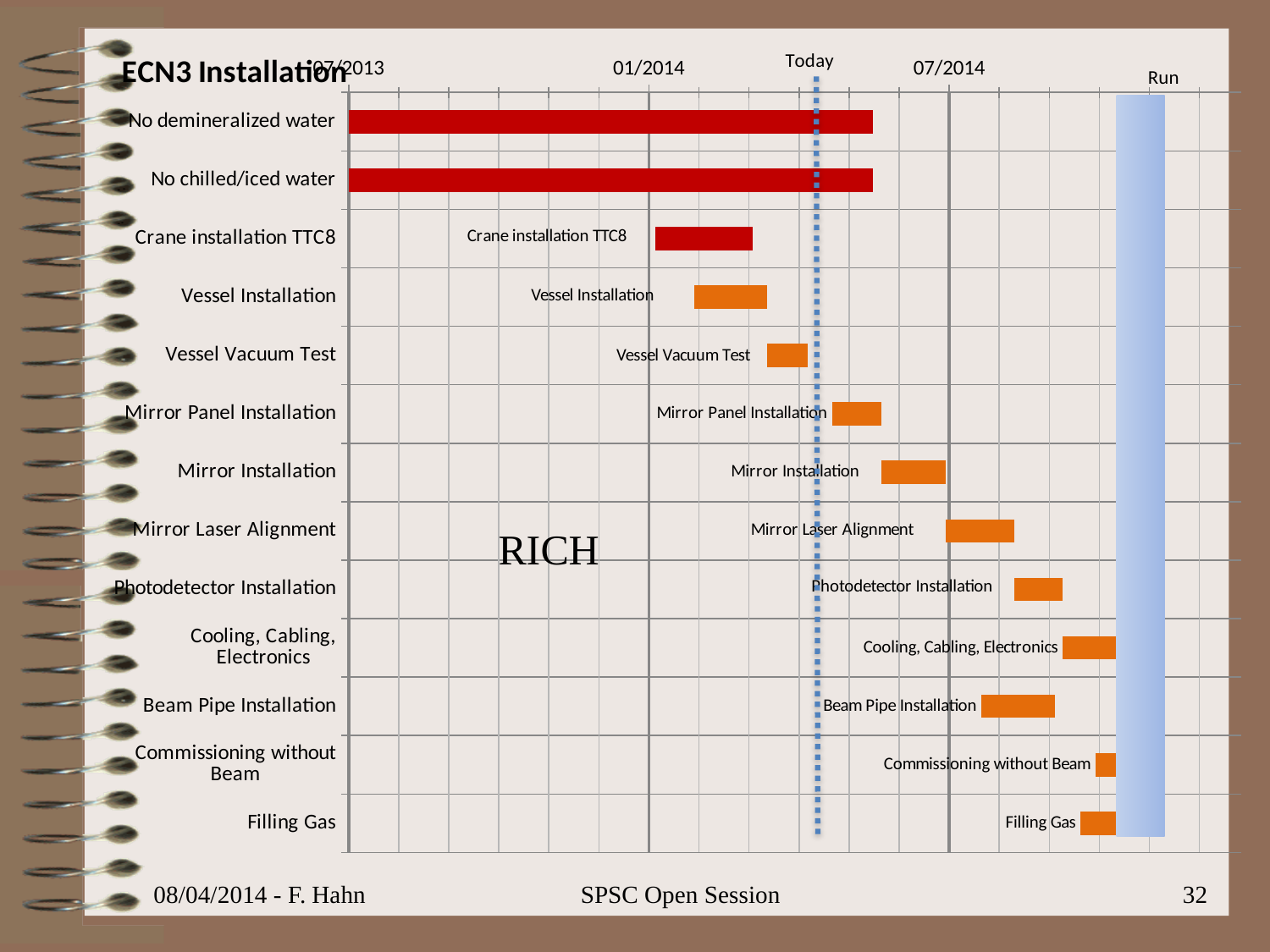
What label marks the dashed vertical line on the chart? Today Does the Mirror Installation bar start before or after the Today line? after What is the title of the chart? ECN3 Installation What kind of chart is shown on the slide? bar chart (Gantt chart) Which bar is longer: No demineralized water or Crane installation TTC8? No demineralized water How many tasks are listed on the vertical axis of the chart? 13 Does the Vessel Installation bar end before or after the Today line? before Which bar is longer: Crane installation TTC8 or Vessel Installation? Crane installation TTC8 Which task is listed first (at the top) of the chart? No demineralized water Does the Photodetector Installation bar start before or after 07/2014? after Which task is listed last (at the bottom) of the chart? Filling Gas